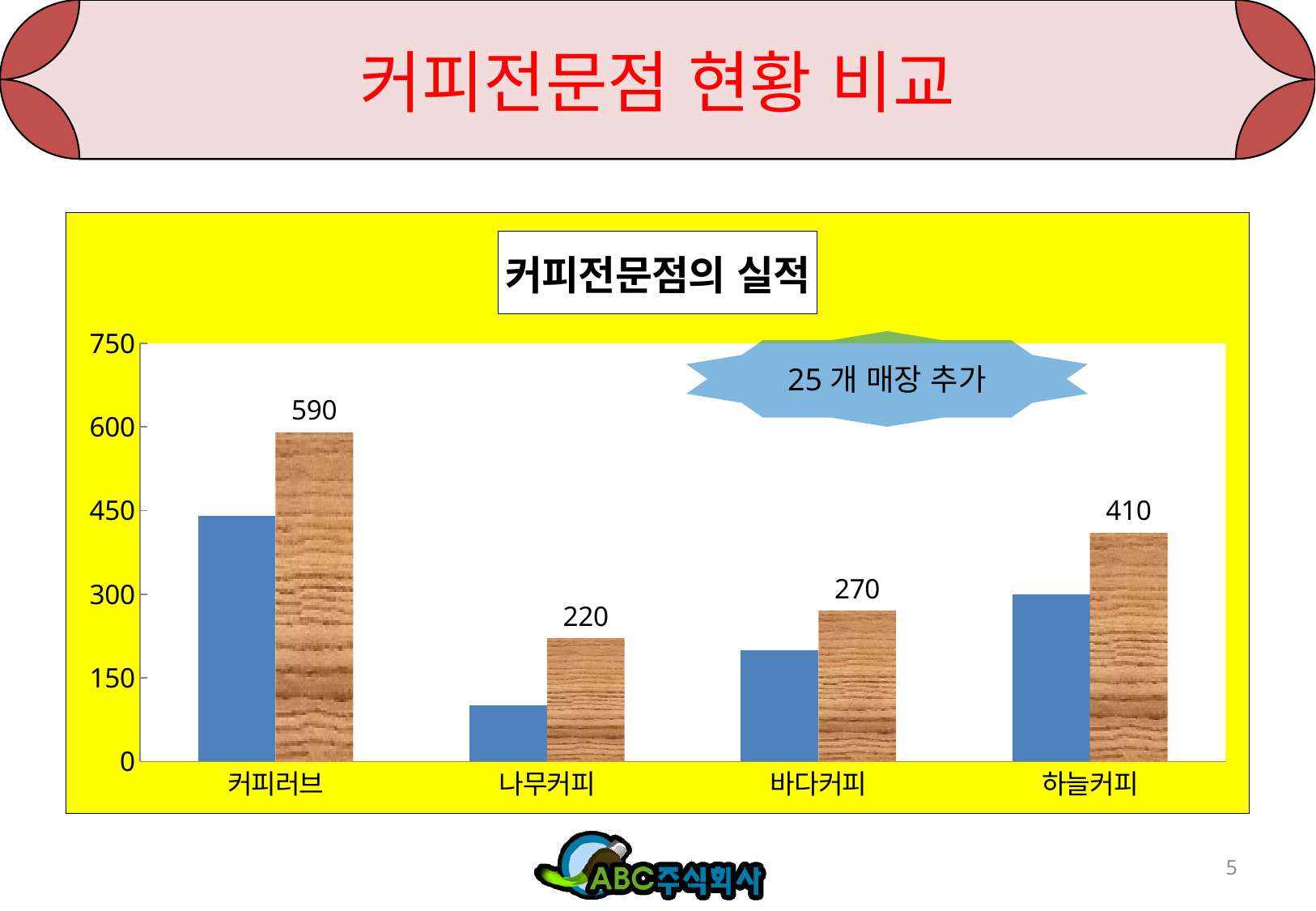
What is the labelled value of the wood-textured bar for 바다커피? 270 What is the labelled value of the wood-textured bar for 나무커피? 220 Which category has the lowest labelled wood-textured bar? 나무커피 What is the labelled value of the wood-textured bar for 커피러브? 590 What is the difference between the labelled values for 커피러브 and 하늘커피? 180 Is the blue bar for 커피러브 greater or less than 300? greater Is the blue bar for 나무커피 greater or less than 150? less How many categories are shown on the x axis of the chart? 4 What is the labelled value of the wood-textured bar for 하늘커피? 410 What is the title of the chart? 커피전문점의 실적 Which category has the highest labelled wood-textured bar? 커피러브 What kind of chart is shown on the slide? bar chart